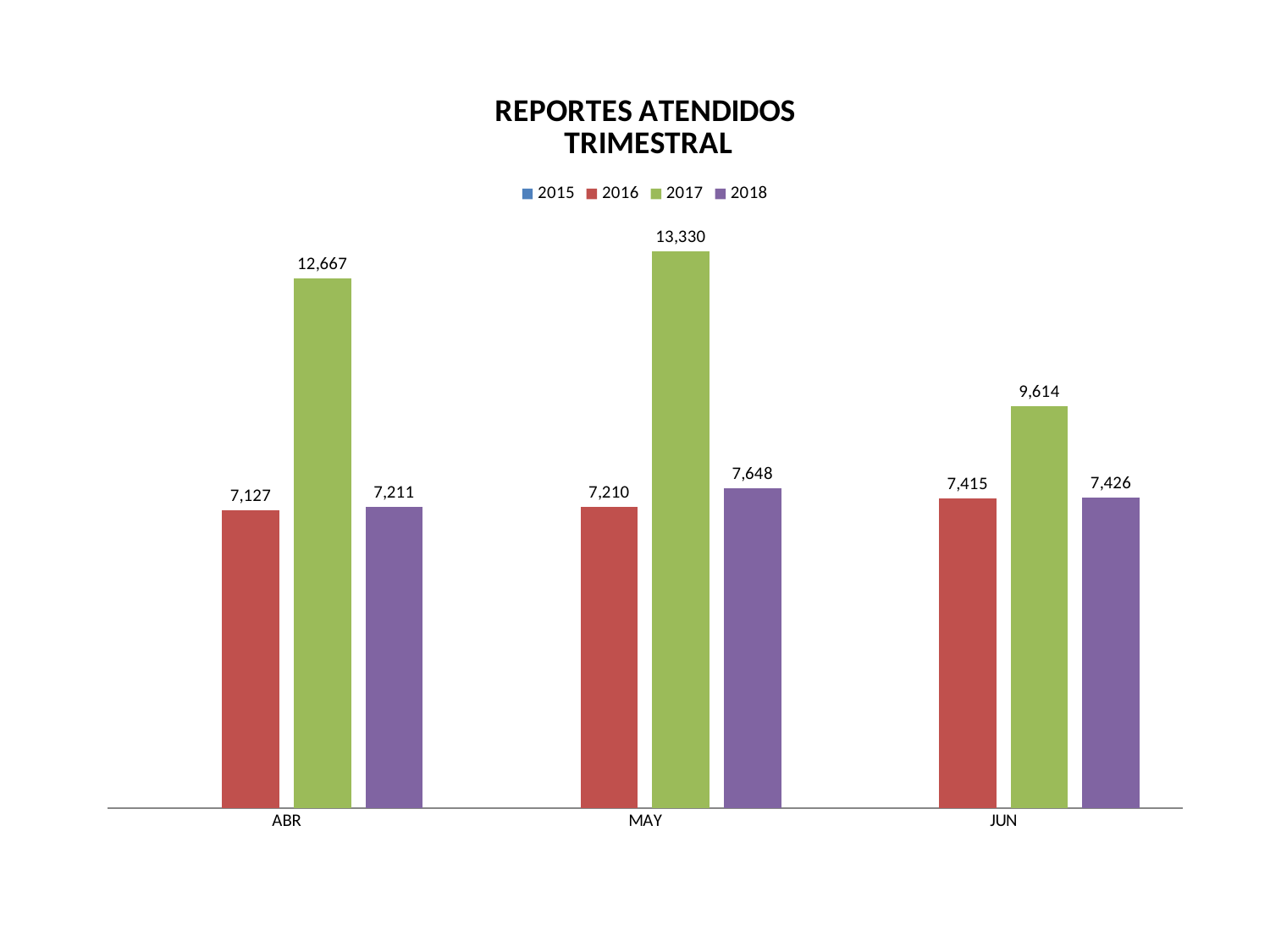
In which month is the 2016 value lowest? ABR What is the value for 2018 in JUN? 7,426 What is the title of the chart? REPORTES ATENDIDOS TRIMESTRAL What is the value for 2017 in MAY? 13,330 How many months are shown on the x axis? 3 Which is larger in MAY, the 2016 value or the 2018 value? 2018 What is the difference between the 2017 and 2018 values in ABR? 5,456 What is the difference between the 2017 values in MAY and JUN? 3,716 What is the value for 2016 in ABR? 7,127 How many series does the legend list? 4 In which month is the 2017 value highest? MAY What kind of chart is shown on the slide? bar chart